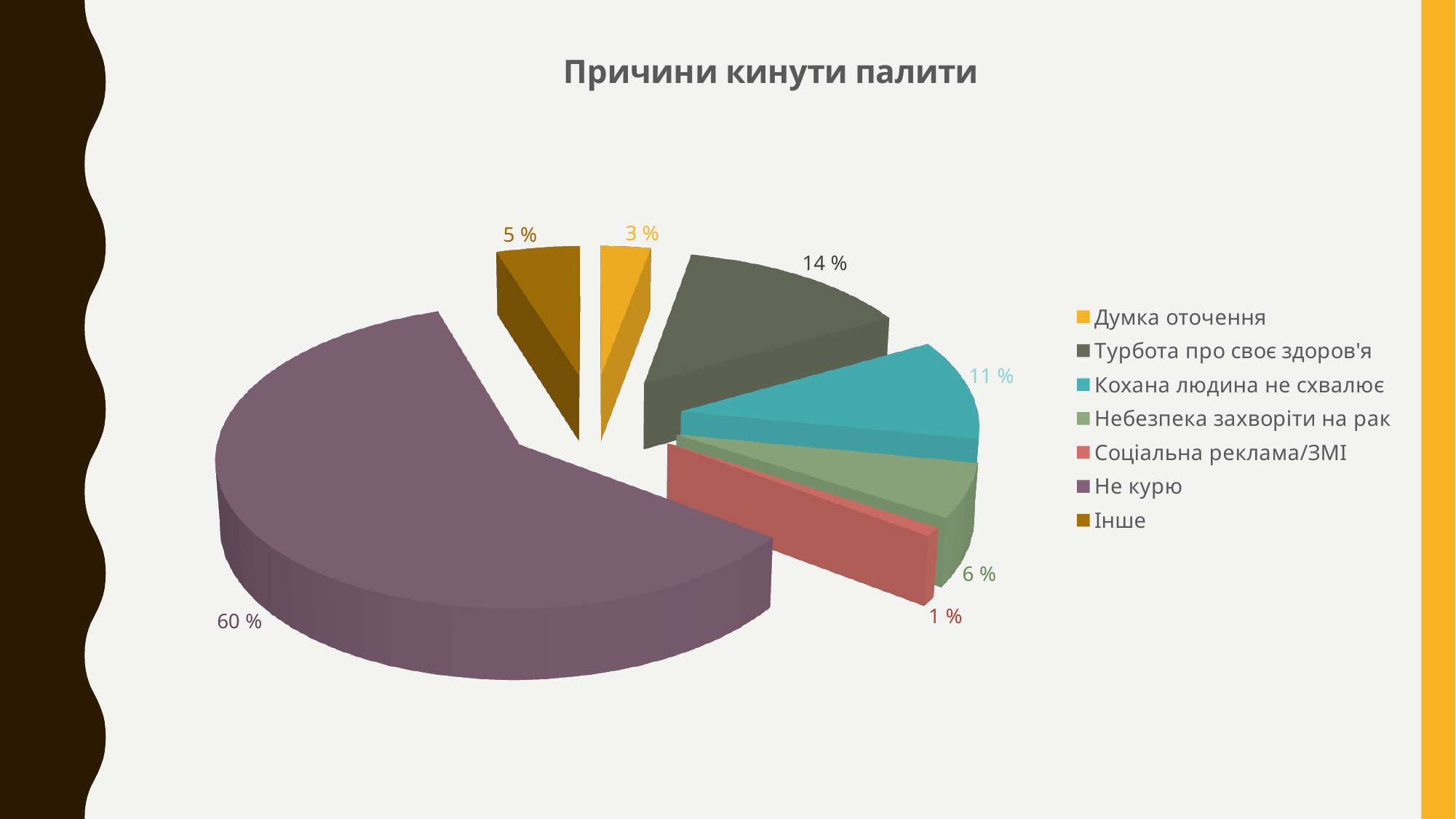
What kind of chart is shown on the slide? pie chart How many categories does the legend list? 7 What is the title of the chart? Причини кинути палити Which category has the smallest slice of the pie? Соціальна реклама/ЗМІ What is the difference between the values for "Турбота про своє здоров'я" and "Кохана людина не схвалює"? 3 % Which is larger, the value for "Небезпека захворіти на рак" or the value for "Інше"? Небезпека захворіти на рак What share of the pie is labelled for "Не курю"? 60 % What value is shown for "Соціальна реклама/ЗМІ"? 1 % What value is shown for "Кохана людина не схвалює"? 11 % Which category has the largest slice of the pie? Не курю What value is shown for "Турбота про своє здоров'я"? 14 % What value is shown for "Думка оточення"? 3 %